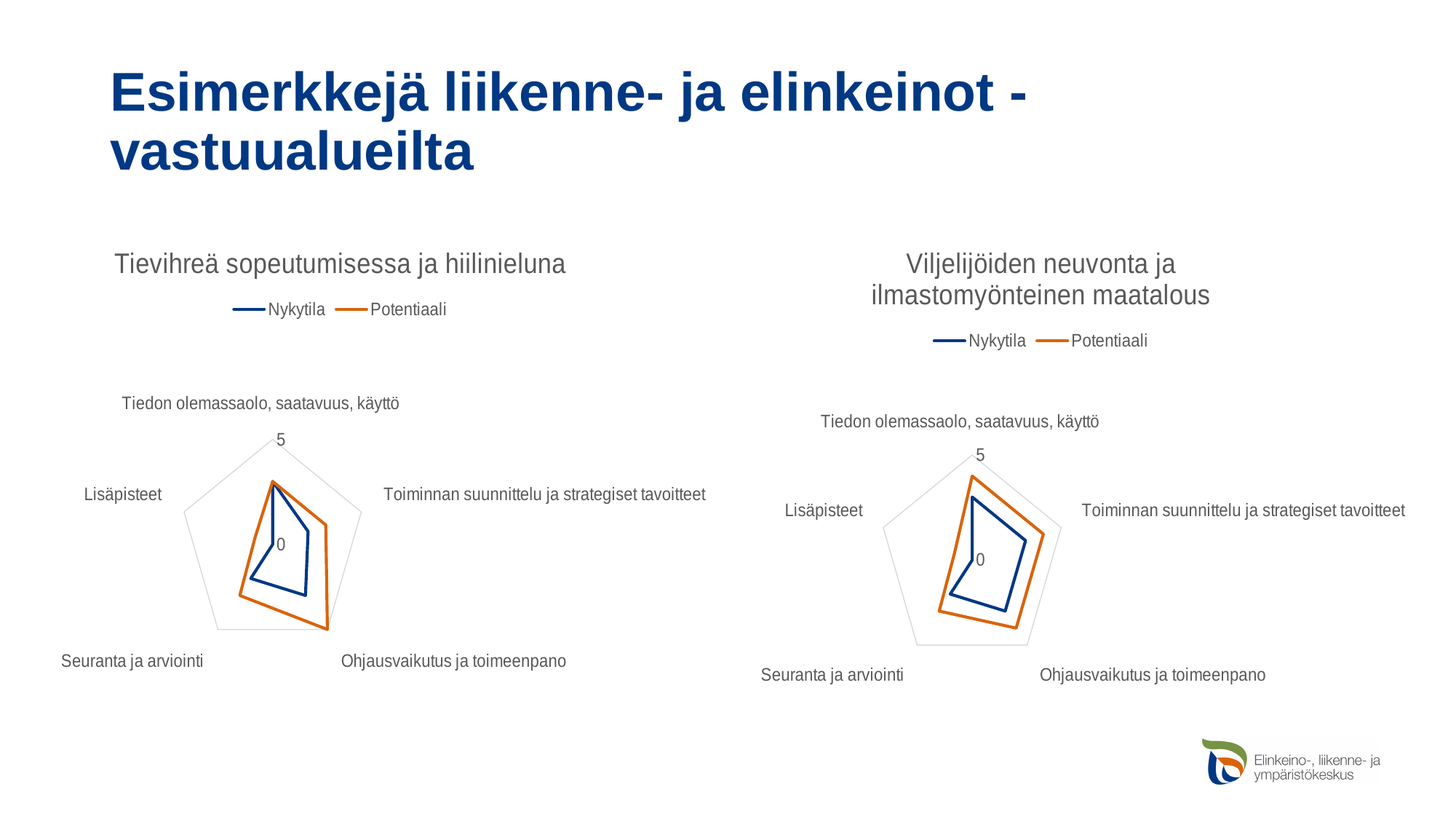
In the left chart, for which category is the Nykytila value lowest? Lisäpisteet What kind of chart is the chart titled "Tievihreä sopeutumisessa ja hiilinieluna"? radar chart How many categories (axes) does the chart titled "Tievihreä sopeutumisessa ja hiilinieluna" have? 5 In the right chart, for which category is the Nykytila value lowest? Lisäpisteet In the right chart, for which category is the Potentiaali value lowest? Lisäpisteet In the right chart, which series has the larger value for "Seuranta ja arviointi", Nykytila or Potentiaali? Potentiaali In the left chart, for which category is the Potentiaali value highest? Ohjausvaikutus ja toimeenpano In the left chart, which series has the larger value for "Ohjausvaikutus ja toimeenpano", Nykytila or Potentiaali? Potentiaali In the right chart, which series has the larger value for "Tiedon olemassaolo, saatavuus, käyttö", Nykytila or Potentiaali? Potentiaali What is the maximum value shown on the axis of the right chart? 5 Which series are listed in the legend of the left chart? Nykytila and Potentiaali How many series does the legend of the chart titled "Viljelijöiden neuvonta ja ilmastomyönteinen maatalous" list? 2